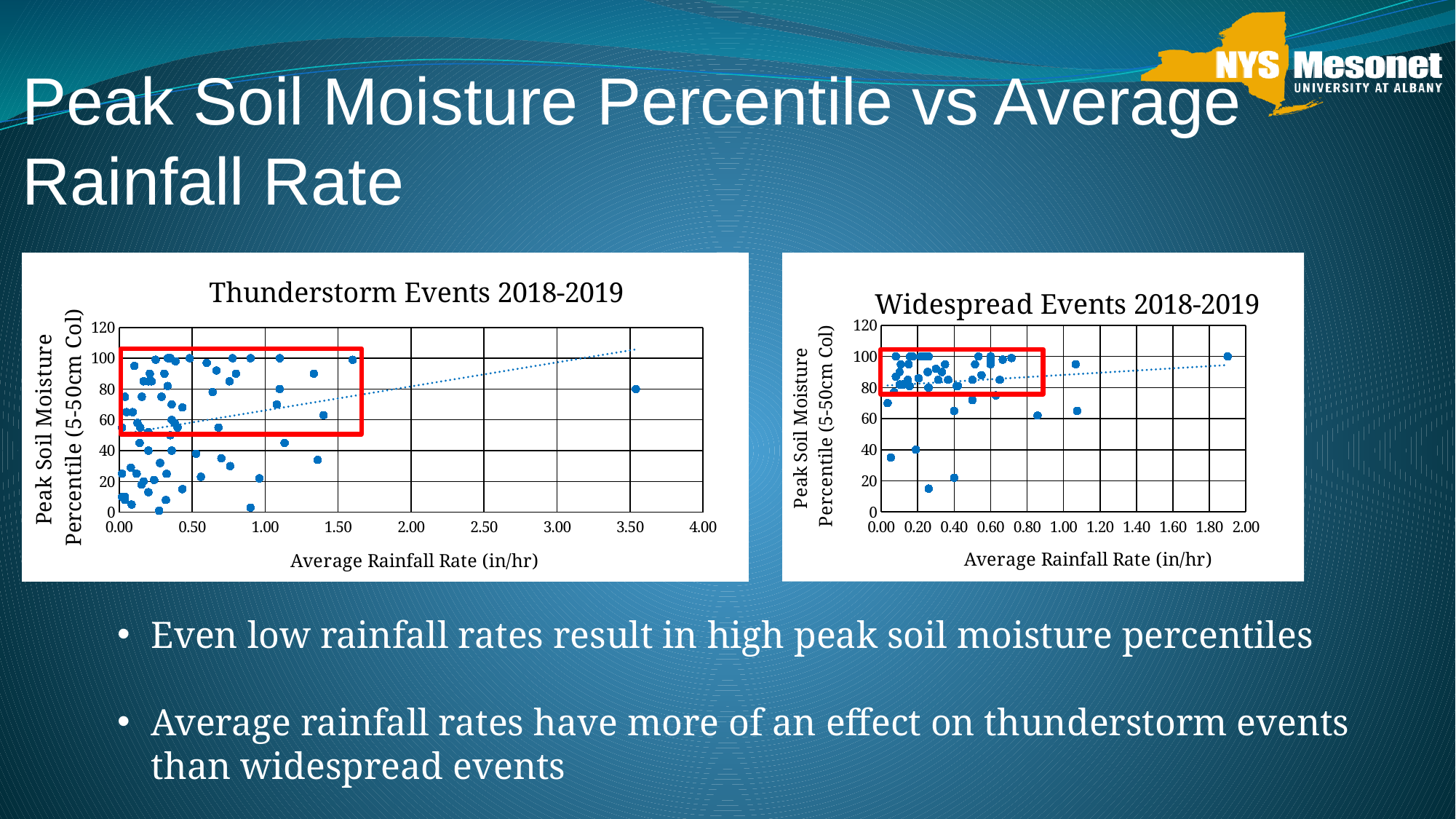
How many charts are shown on the slide? 2 In the "Widespread Events 2018-2019" chart, does the dotted trend line rise or fall as average rainfall rate increases? rises What is the maximum value shown on the x axis of the "Thunderstorm Events 2018-2019" chart? 4.00 In the "Widespread Events 2018-2019" chart, is the peak soil moisture percentile of the rightmost point (near 1.90 in/hr) greater or less than 80? greater What kind of chart is the "Widespread Events 2018-2019" chart? scatter chart What kind of chart is the "Thunderstorm Events 2018-2019" chart? scatter chart Which chart has the larger x-axis range, "Thunderstorm Events 2018-2019" or "Widespread Events 2018-2019"? Thunderstorm Events 2018-2019 What is the maximum value shown on the x axis of the "Widespread Events 2018-2019" chart? 2.00 In the "Thunderstorm Events 2018-2019" chart, does the dotted trend line rise or fall as average rainfall rate increases? rises In the "Thunderstorm Events 2018-2019" chart, is the peak soil moisture percentile of the point at about 3.50 in/hr greater or less than 60? greater